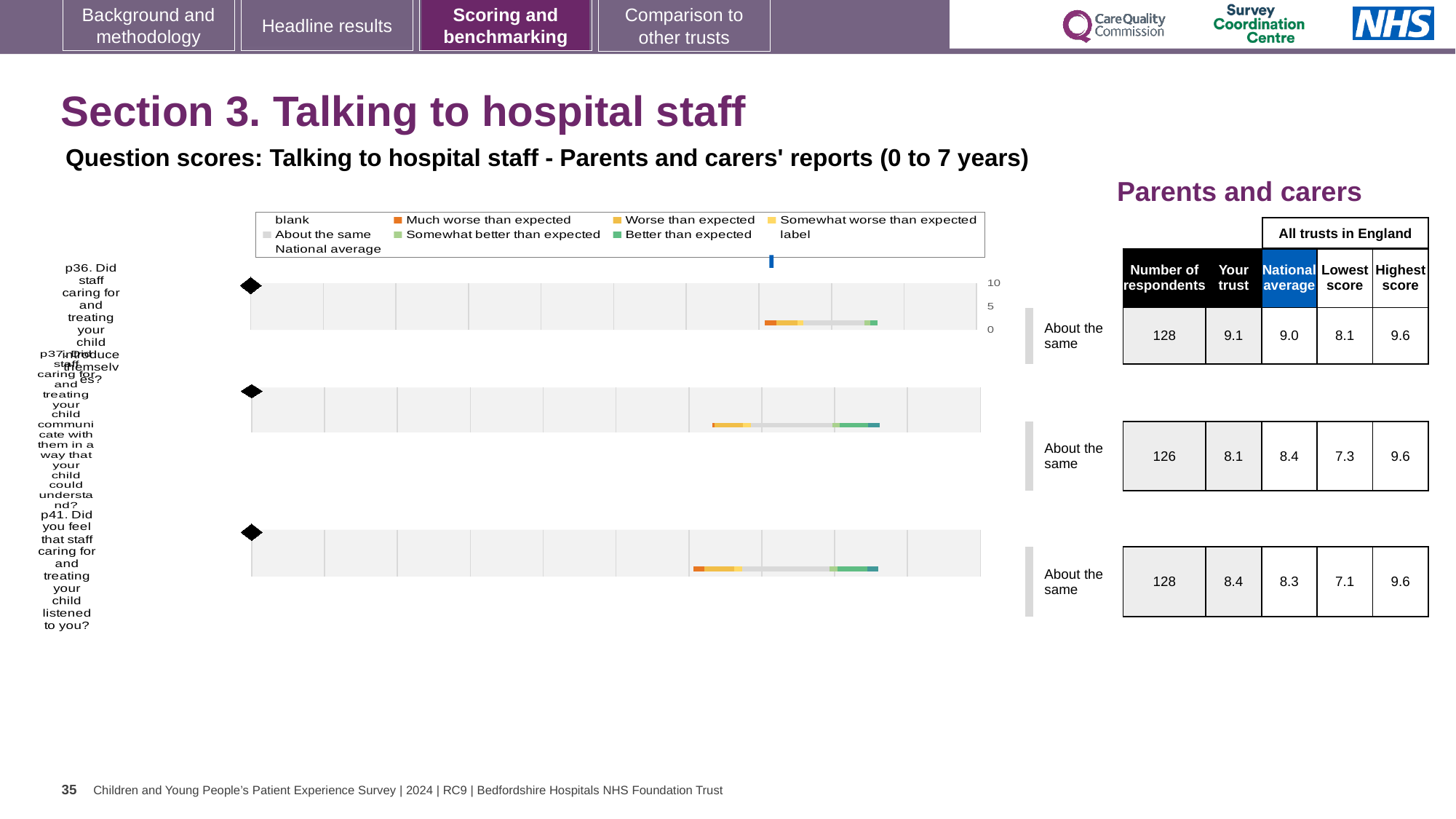
Which legend entry is shown in orange? Much worse than expected What is the highest tick value shown on the axis of the first chart (p36)? 10 Which question number does the bottom chart relate to? p41 How many question charts (p36, p37, p41) are shown on the slide? 3 Which question number does the top chart relate to? p36 What kind of chart is used to show the question scores on this slide? bar chart How many entries does the legend above the charts list? 9